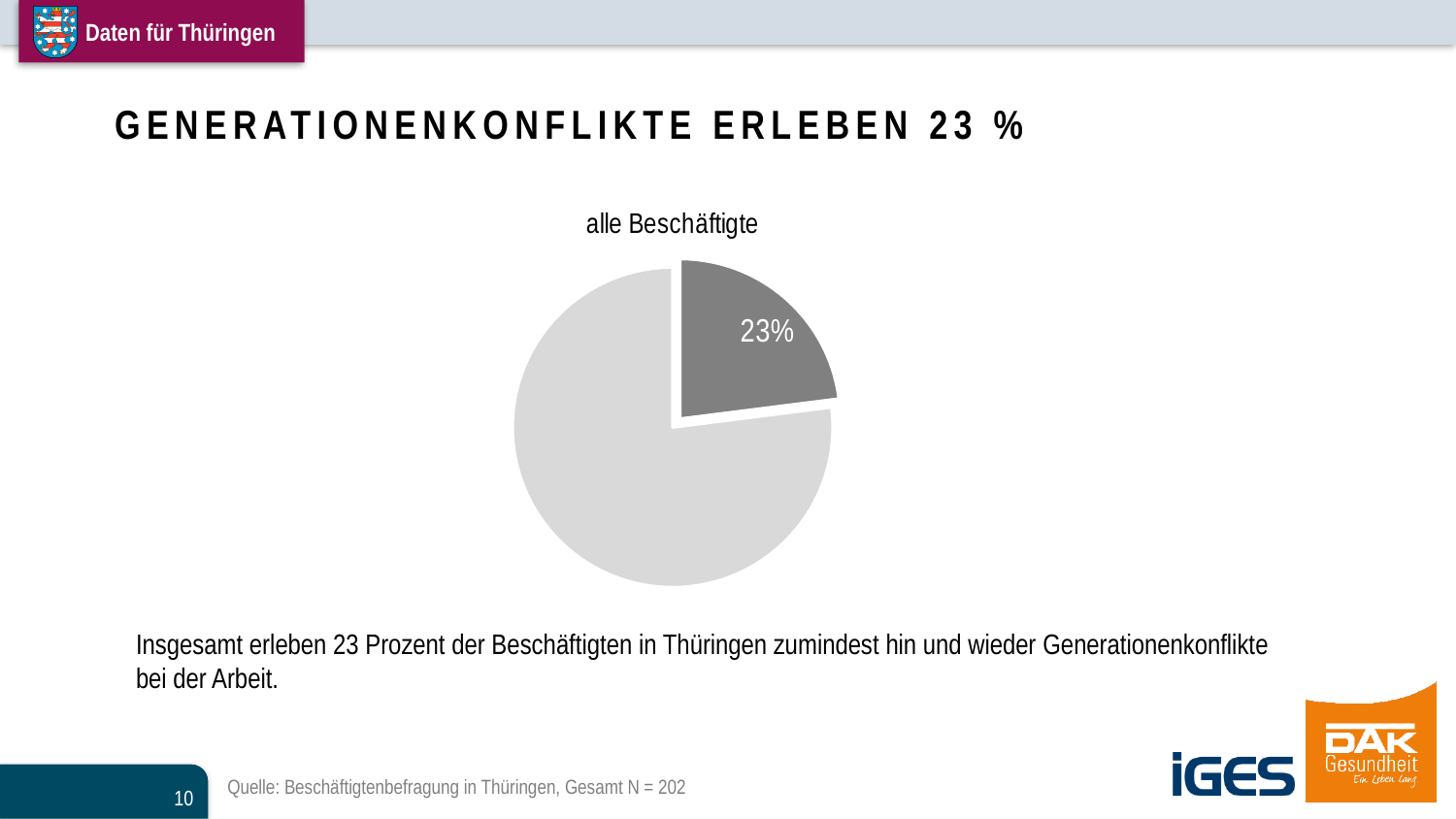
How many slices does the pie chart have? 2 What percentage is printed on the labelled slice of the pie chart? 23% Is the labelled slice of the pie chart greater or less than 50% of the pie? less What colour is the slice labelled 23% in the pie chart? dark grey Which slice of the pie chart is larger, the dark grey labelled slice or the light grey unlabelled slice? the light grey unlabelled slice What is the title of the pie chart? alle Beschäftigte Which slice of the pie chart is the smallest? the dark grey 23% slice What kind of chart is shown on the slide? pie chart What share of the pie does the dark grey slice represent? 23%